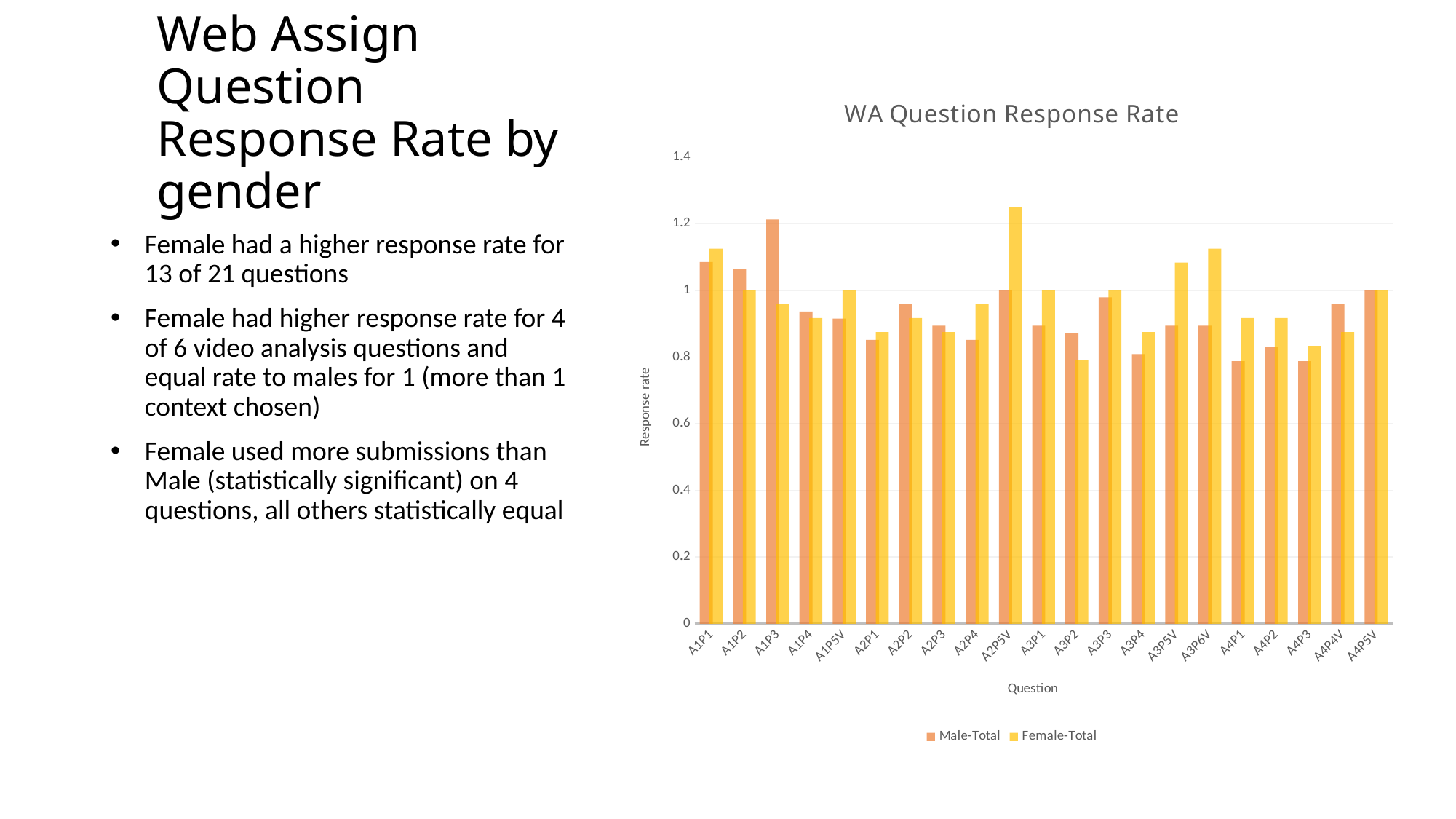
Is the Female-Total value for A3P6V greater or less than 1? greater How many questions (categories) are shown on the x axis of the chart? 21 Which question has the highest Male-Total response rate? A1P3 What type of chart is shown on the slide? Bar chart Which question has the highest Female-Total response rate? A2P5V What label is shown on the y axis of the chart? Response rate What is the title of the chart? WA Question Response Rate For question A1P3, which series has the larger value, Male-Total or Female-Total? Male-Total For question A3P5V, which series has the larger value, Male-Total or Female-Total? Female-Total Is the Female-Total value for A2P5V greater or less than 1.2? greater How many series does the chart legend list? 2 Is the Male-Total value for A2P1 greater or less than 1? less